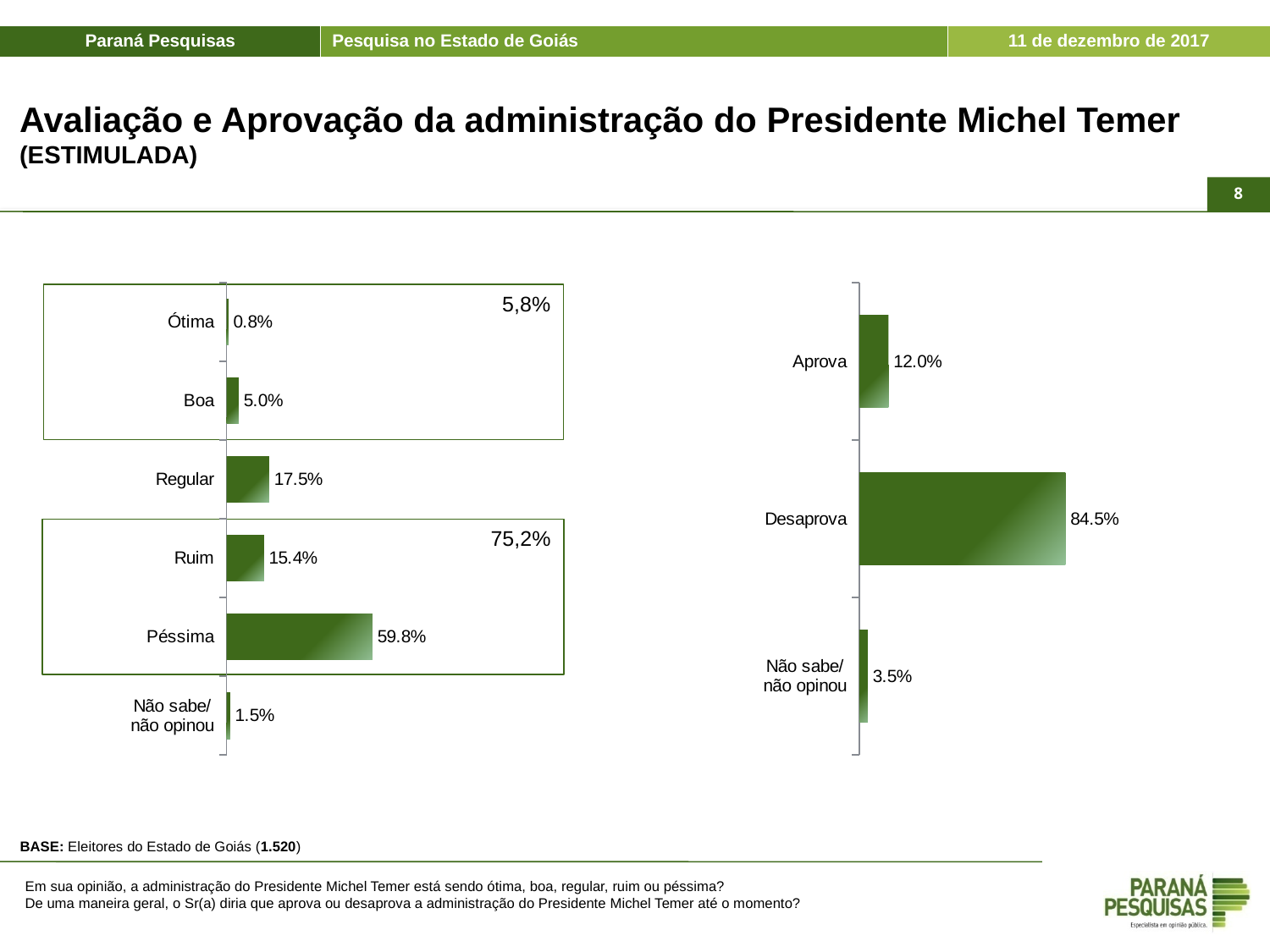
In the right chart, what is the value for Aprova? 12.0% In the left chart, which is larger, Regular or Ruim? Regular In the right chart, which category has the lowest value? Não sabe/não opinou In the left chart, what is the value for Péssima? 59.8% In the left chart, which category has the highest value? Péssima How many categories does the left chart show? 6 In the left chart, which category has the lowest value? Ótima In the right chart, what is the difference between Desaprova and Aprova? 72.5% What kind of chart is the right chart? Bar chart In the right chart, what is the value for Desaprova? 84.5% How many categories does the right chart show? 3 In the left chart, what is the value for Regular? 17.5%